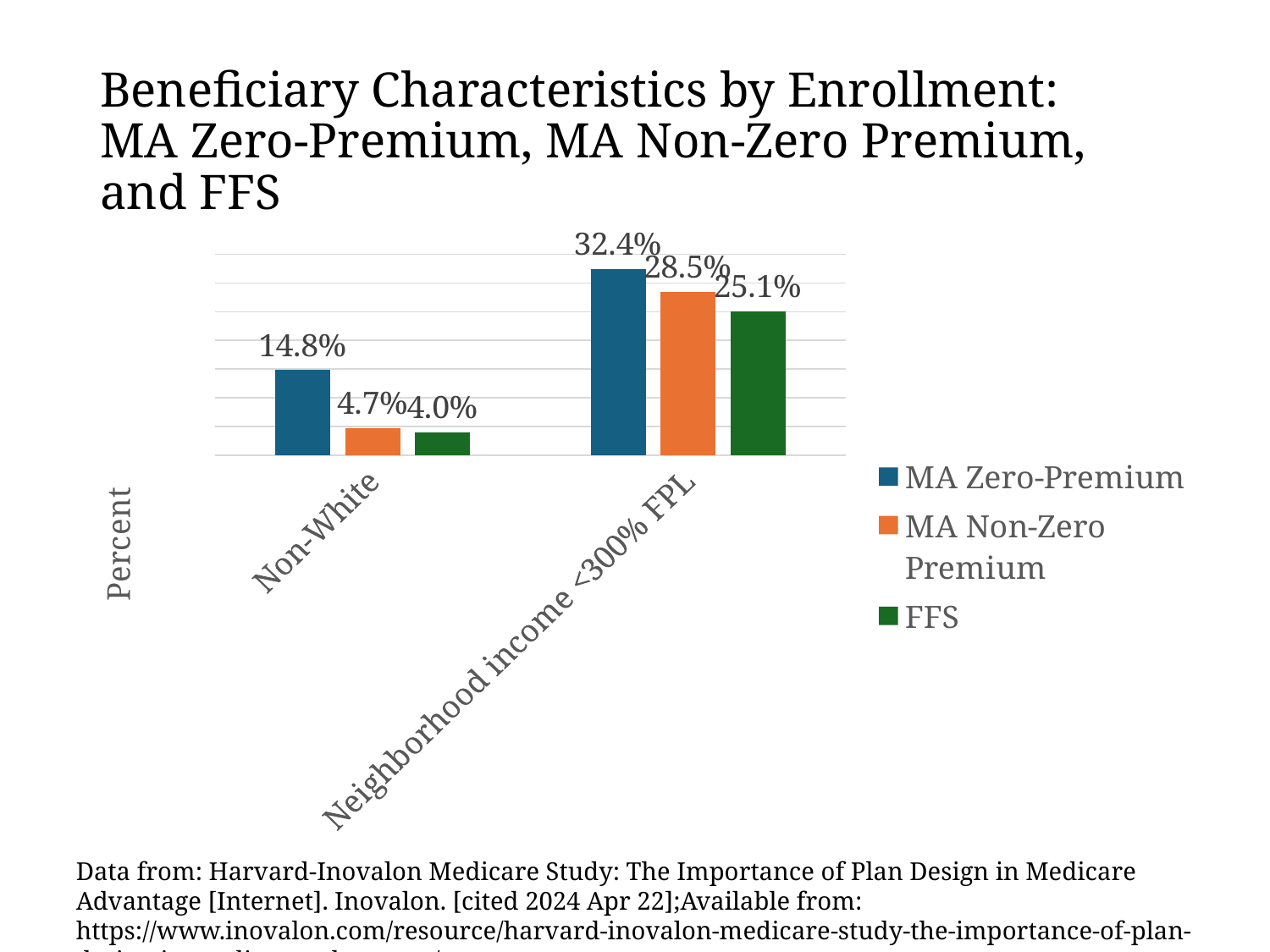
What is the value for FFS in the Neighborhood income <300% FPL category? 25.1% What is the difference between MA Zero-Premium and FFS in the Neighborhood income <300% FPL category? 7.3% What is the value for MA Non-Zero Premium in the Non-White category? 4.7% How many categories are shown on the x axis? 2 How many series does the legend list? 3 Which series has the lowest value in the Non-White category? FFS Which is larger: MA Non-Zero Premium for Non-White or MA Non-Zero Premium for Neighborhood income <300% FPL? Neighborhood income <300% FPL What is the difference between MA Zero-Premium and MA Non-Zero Premium in the Non-White category? 10.1% What kind of chart is shown on the slide? Bar chart What is the label of the y axis? Percent Which series has the highest value in the Neighborhood income <300% FPL category? MA Zero-Premium What is the value for MA Zero-Premium in the Non-White category? 14.8%